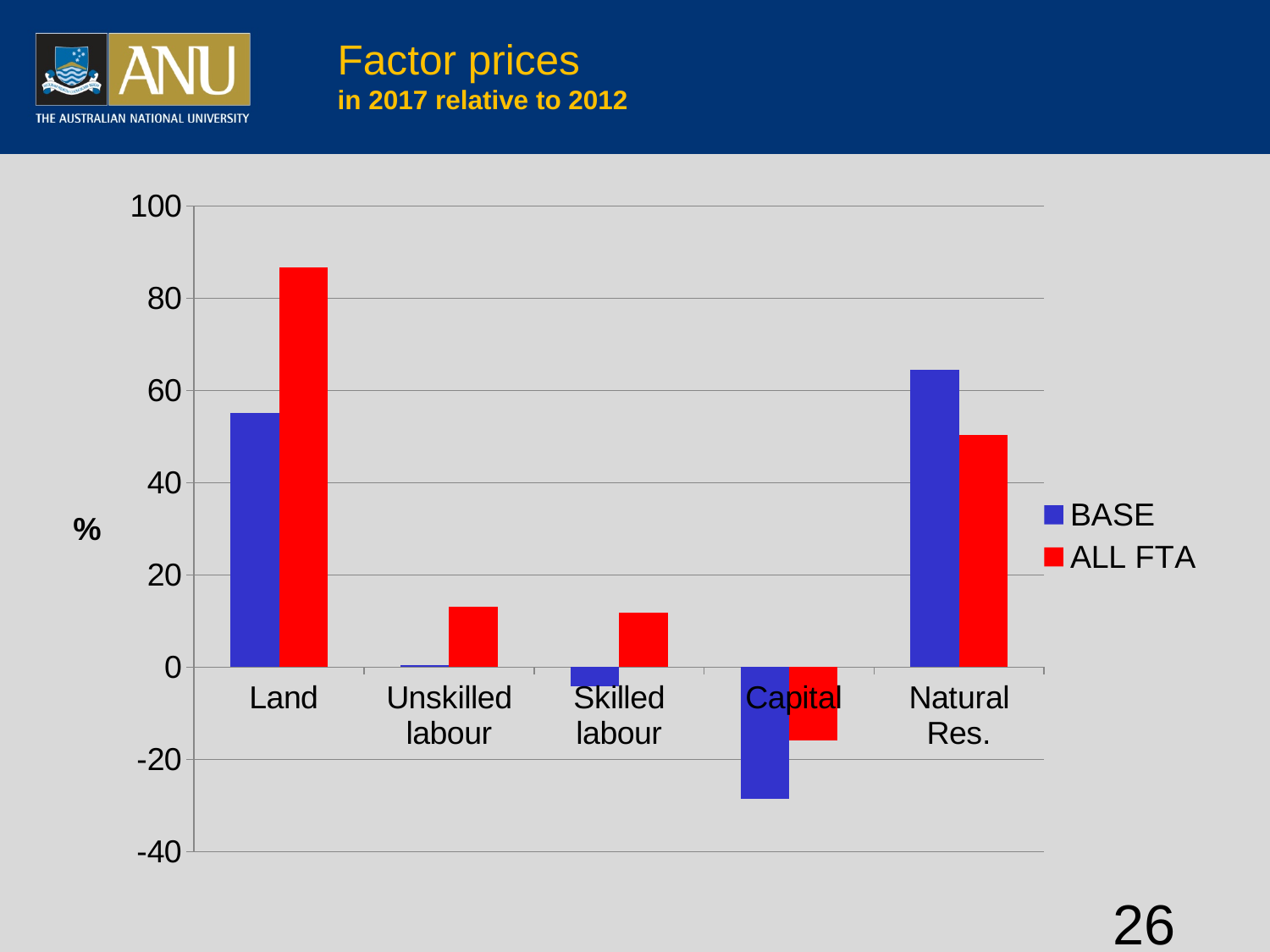
Is the BASE value for Capital greater or less than -20? less What is the label on the vertical axis of the chart? % What kind of chart is shown on the slide? bar chart For Natural Res., which series has the larger value, BASE or ALL FTA? BASE Which category has the lowest BASE value? Capital Which category has the highest BASE value? Natural Res. Is the ALL FTA value for Land greater or less than 80? greater How many series does the legend list? 2 How many categories are shown on the x axis? 5 Which category has the lowest ALL FTA value? Capital For Land, which series has the larger value, BASE or ALL FTA? ALL FTA Which category has the highest ALL FTA value? Land